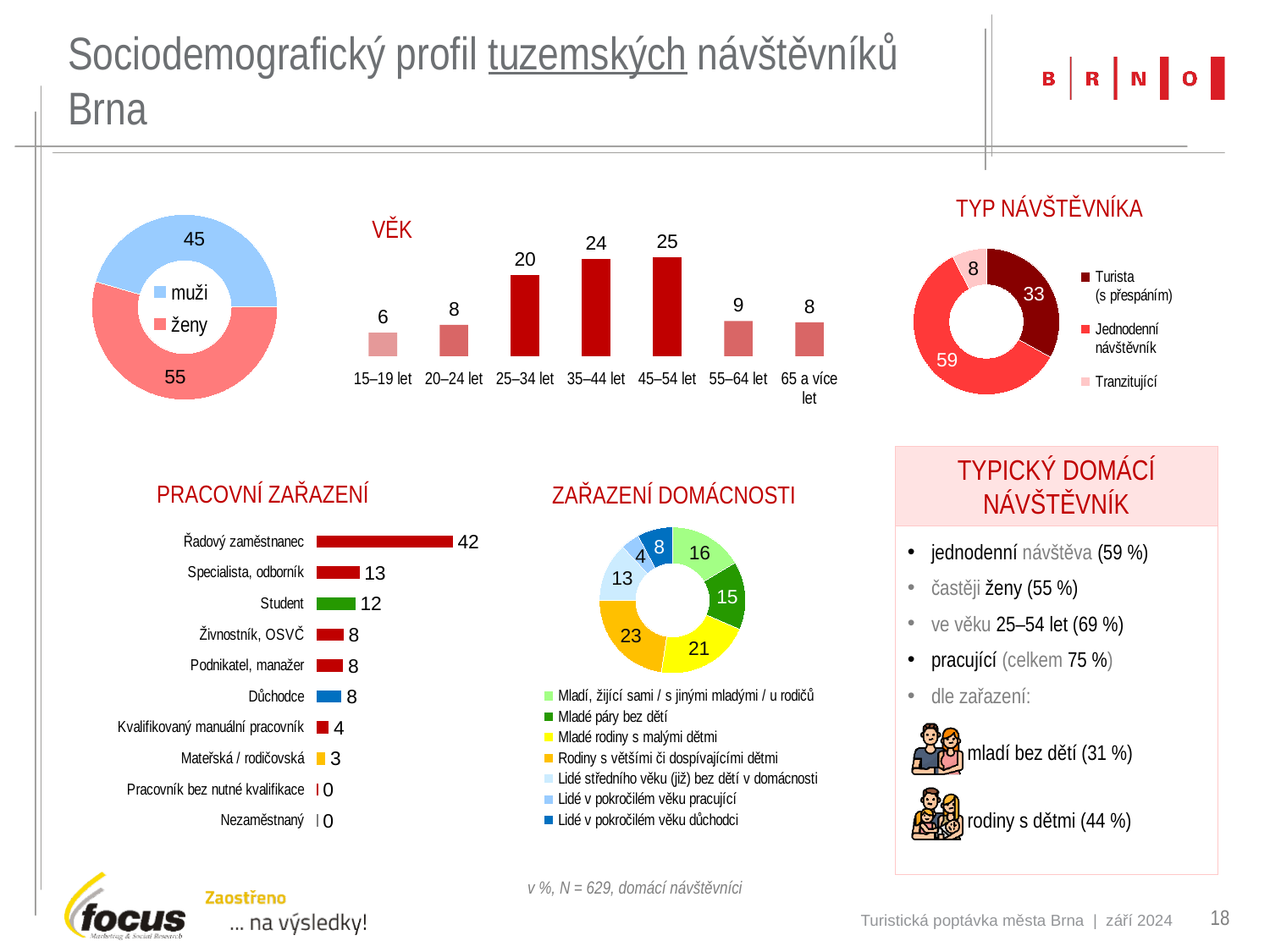
How many age groups are shown in the VĚK bar chart? 7 In the VĚK bar chart, what is the value for the 35–44 let age group? 24 In the VĚK bar chart, which age group has the lowest value? 15–19 let In the PRACOVNÍ ZAŘAZENÍ chart, what is the value for Specialista, odborník? 13 In the ZAŘAZENÍ DOMÁCNOSTI donut chart, which category is larger: Mladé rodiny s malými dětmi or Mladé páry bez dětí? Mladé rodiny s malými dětmi In the TYP NÁVŠTĚVNÍKA donut chart, which category has the smallest value? Tranzitující In the PRACOVNÍ ZAŘAZENÍ chart, which category has the highest value? Řadový zaměstnanec What type of chart is the PRACOVNÍ ZAŘAZENÍ chart? Bar chart In the VĚK bar chart, which age group has the highest value? 45–54 let In the gender donut chart at the top left, what is the value for ženy? 55 In the VĚK bar chart, what is the difference between the values for 25–34 let and 15–19 let? 14 In the TYP NÁVŠTĚVNÍKA donut chart, what is the value for Jednodenní návštěvník? 59